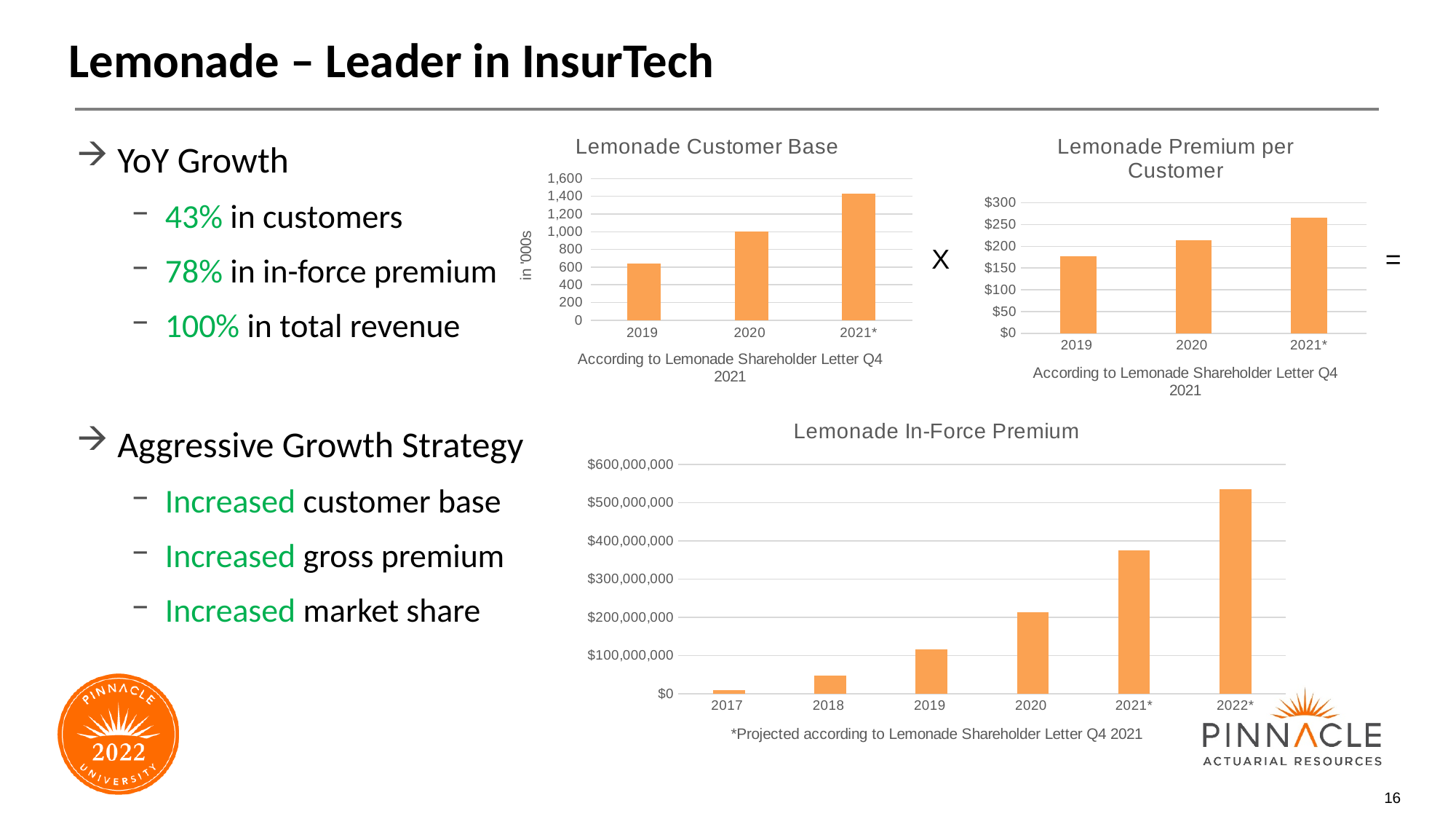
In the Lemonade Customer Base chart, is the value for 2019 greater or less than 800? less In the Lemonade In-Force Premium chart, which is larger, the value for 2019 or the value for 2020? 2020 In the Lemonade Customer Base chart, is the value for 2021* greater or less than 1,200? greater In the Lemonade In-Force Premium chart, is the value for 2022* greater or less than $500,000,000? greater In the Lemonade In-Force Premium chart, do the values rise or fall from 2017 to 2022*? rise What kind of chart is the Lemonade In-Force Premium chart? bar chart In the Lemonade Customer Base chart, which year has the highest customer base? 2021* How many years are shown in the Lemonade In-Force Premium chart? 6 How many years are shown in the Lemonade Customer Base chart? 3 In the Lemonade Premium per Customer chart, which year has the lowest premium per customer? 2019